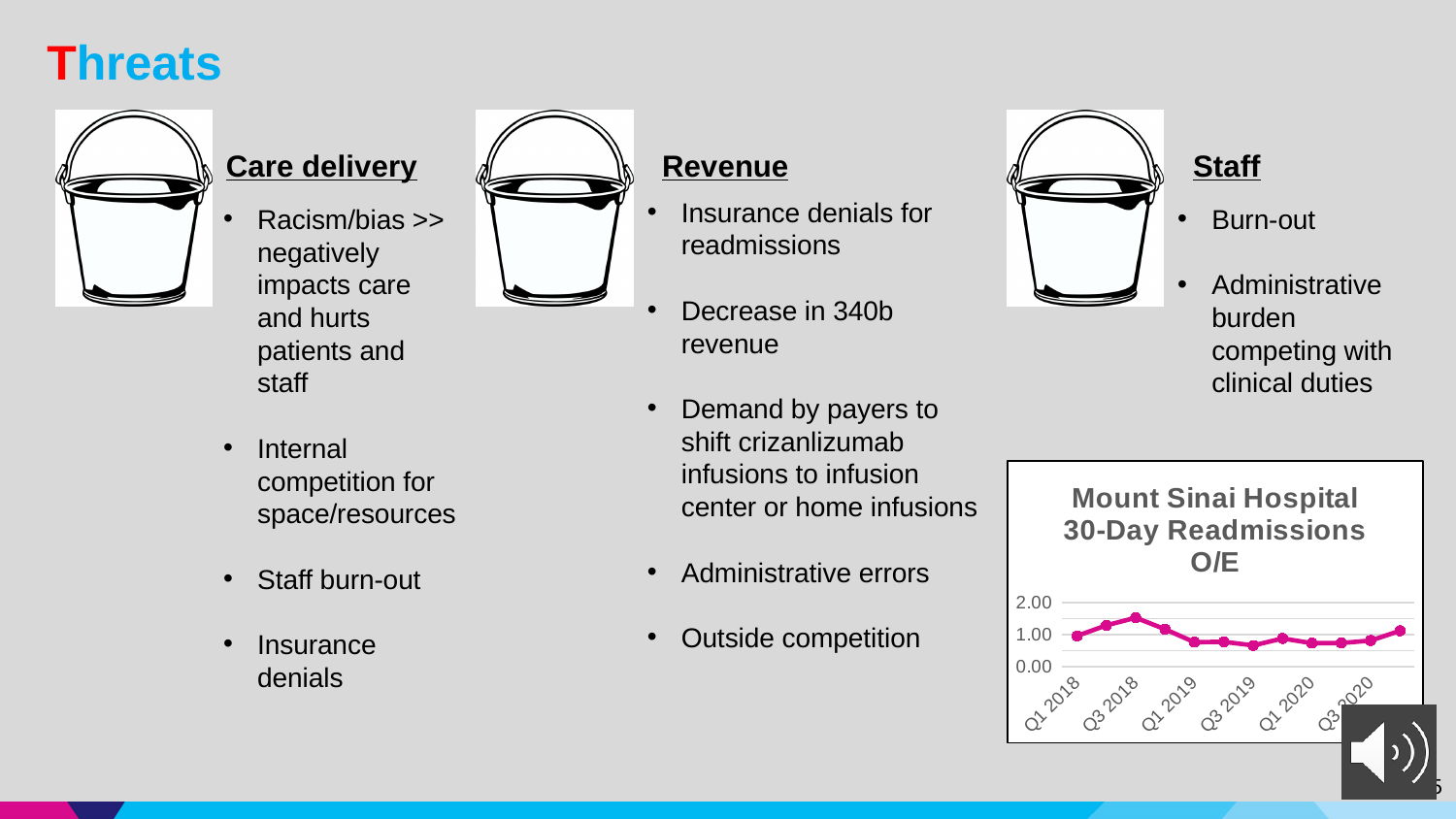
How many quarter labels are shown on the x axis of the chart? 6 Which is larger, the value for Q3 2018 or the value for Q3 2019? Q3 2018 Is the value for Q3 2019 greater or less than 1.00? less Is the value for Q1 2020 greater or less than 1.00? less Is any value in the chart greater or less than 2.00? less Which quarter has the highest 30-Day Readmissions O/E value in the chart? Q3 2018 What is the highest tick value shown on the y axis of the chart? 2.00 What is the title of the chart on the slide? Mount Sinai Hospital 30-Day Readmissions O/E Do the values rise or fall from Q3 2018 to Q3 2019? fall What kind of chart is shown on the slide? line chart